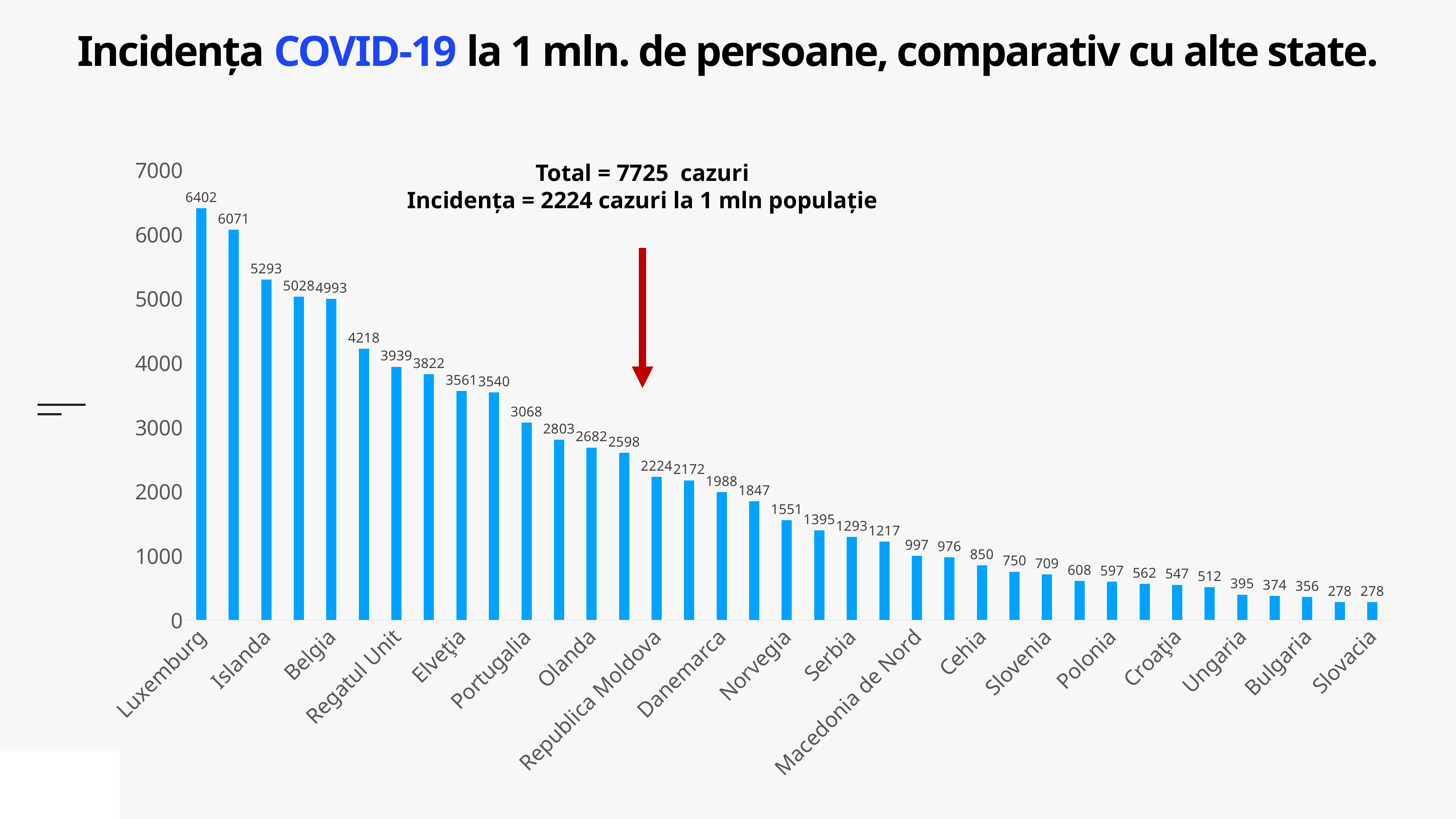
Do the values rise or fall from left to right along the x axis? fall According to the text on the slide, what is the total number of cases? 7725 What is the difference between the values for Luxemburg and Republica Moldova? 4178 What is the COVID-19 incidence per 1 million people for Luxemburg? 6402 What is the value shown for Belgia? 4993 What is the value shown for Republica Moldova? 2224 Is the value for Cehia greater or less than 1000? less Which has a higher value, Islanda or Belgia? Islanda What is the value shown for Slovacia? 278 What kind of chart is shown on the slide? bar chart What is the value shown for Norvegia? 1551 Which country has the highest incidence in the chart? Luxemburg